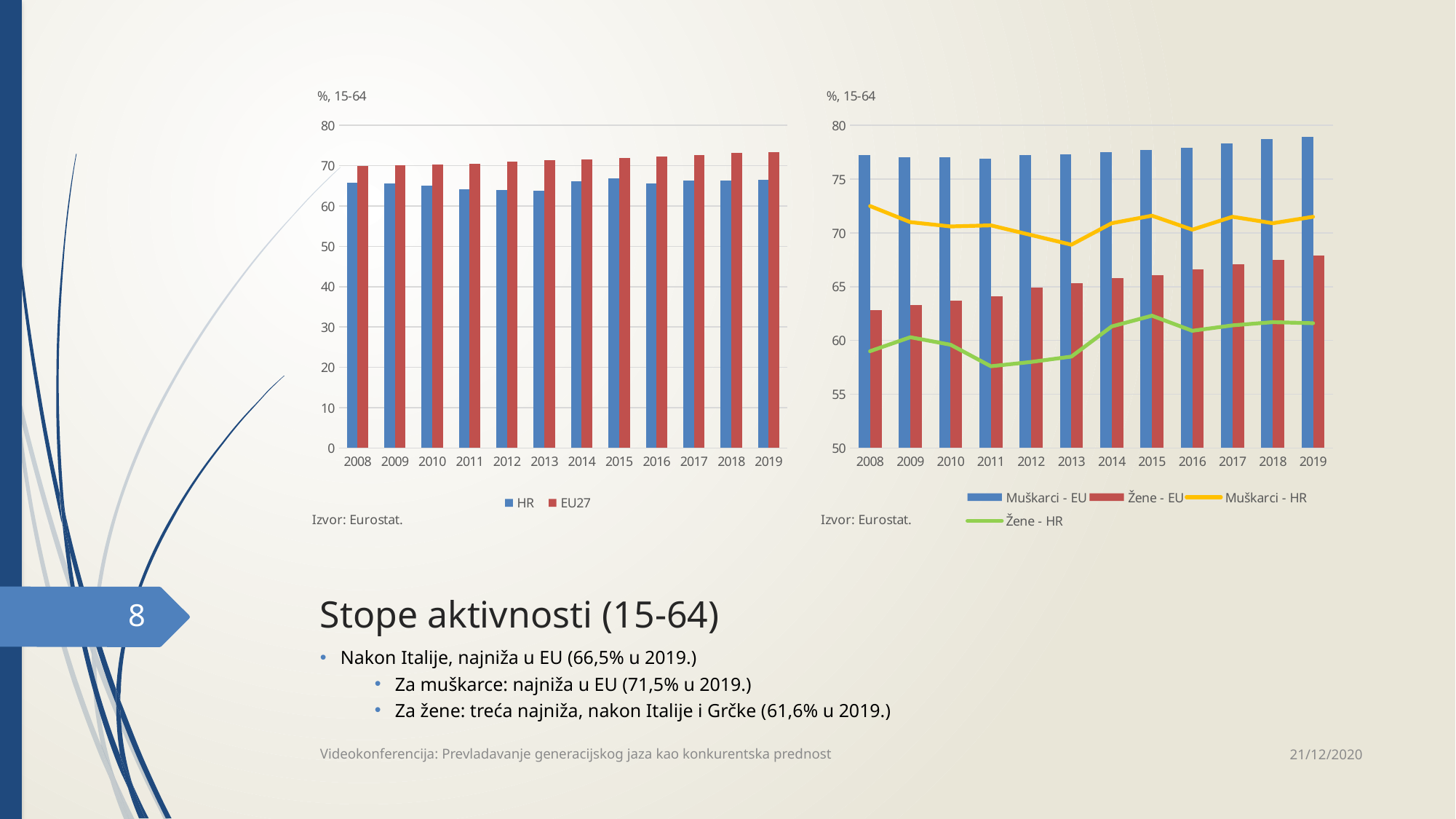
In the right chart, is the value for Muškarci - EU in 2019 greater or less than 75? greater In the right chart, do the Žene - EU values rise or fall from 2008 to 2019? rise How many years are shown on the x axis of the left chart? 12 In the left chart, is the value for HR in 2019 greater or less than 70? less In the right chart, is the value for Žene - HR in 2011 greater or less than 60? less In the left chart, do the EU27 values rise or fall from 2008 to 2019? rise What kind of chart is the left chart (HR vs EU27)? bar chart In the left chart, which series is higher in 2019, HR or EU27? EU27 In the right chart, which series is shown as a yellow line? Muškarci - HR How many series does the legend of the right chart list? 4 How many series does the legend of the left chart list? 2